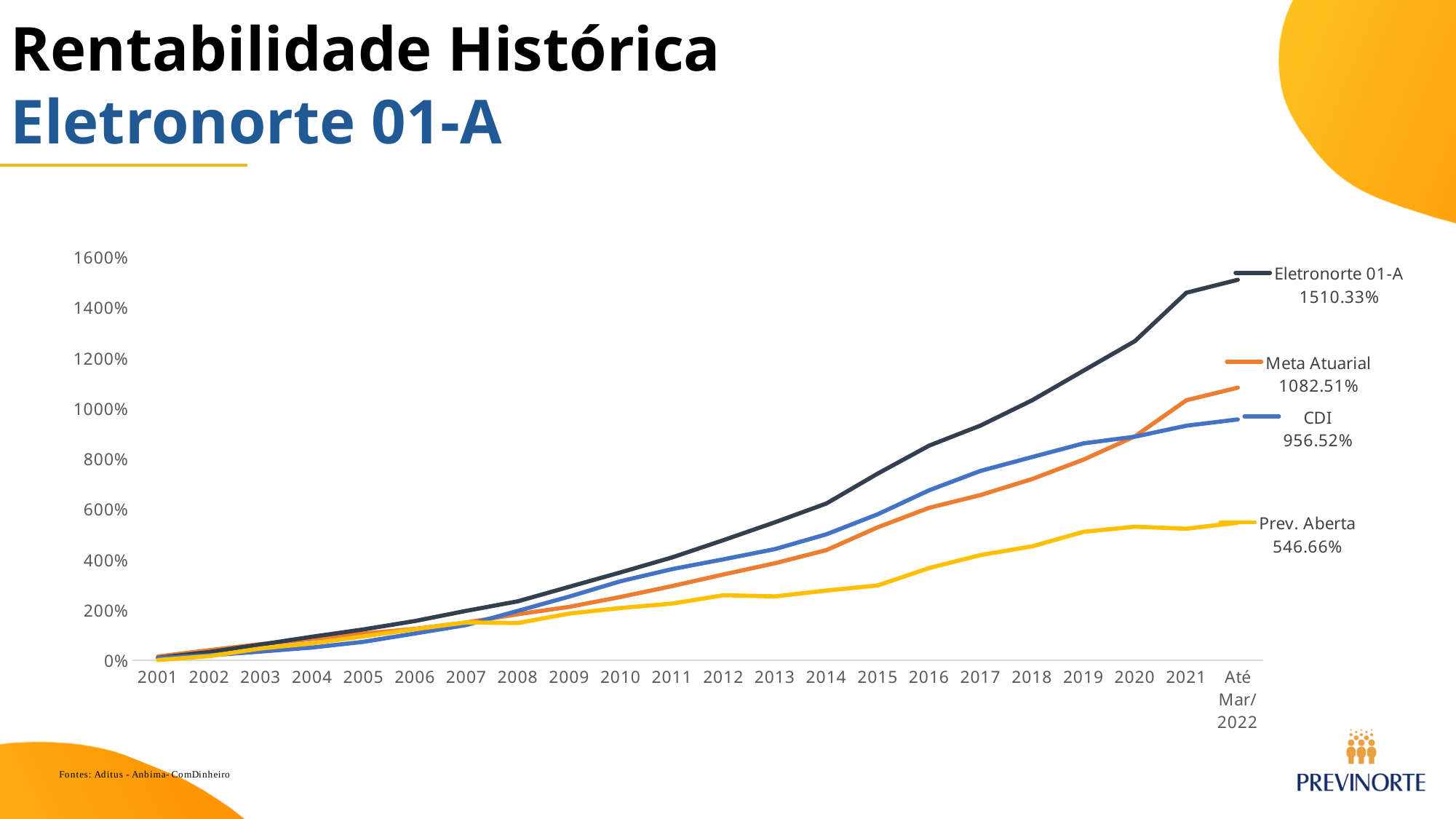
Which series has the highest final value? Eletronorte 01-A What kind of chart is shown on the slide? Line chart What is the final value shown for CDI? 956.52% Which has a larger final value, CDI or Meta Atuarial? Meta Atuarial Do the values for CDI rise or fall from 2001 to 2021? Rise What is the final value shown for Meta Atuarial? 1082.51% What is the final value shown for Prev. Aberta? 546.66% What is the final value shown for Eletronorte 01-A? 1510.33% What is the difference between the final values of Eletronorte 01-A and Meta Atuarial? 427.82% Is the value for Eletronorte 01-A in 2015 greater or less than 600%? greater How many series are shown in the chart? 4 Which series has the lowest final value? Prev. Aberta